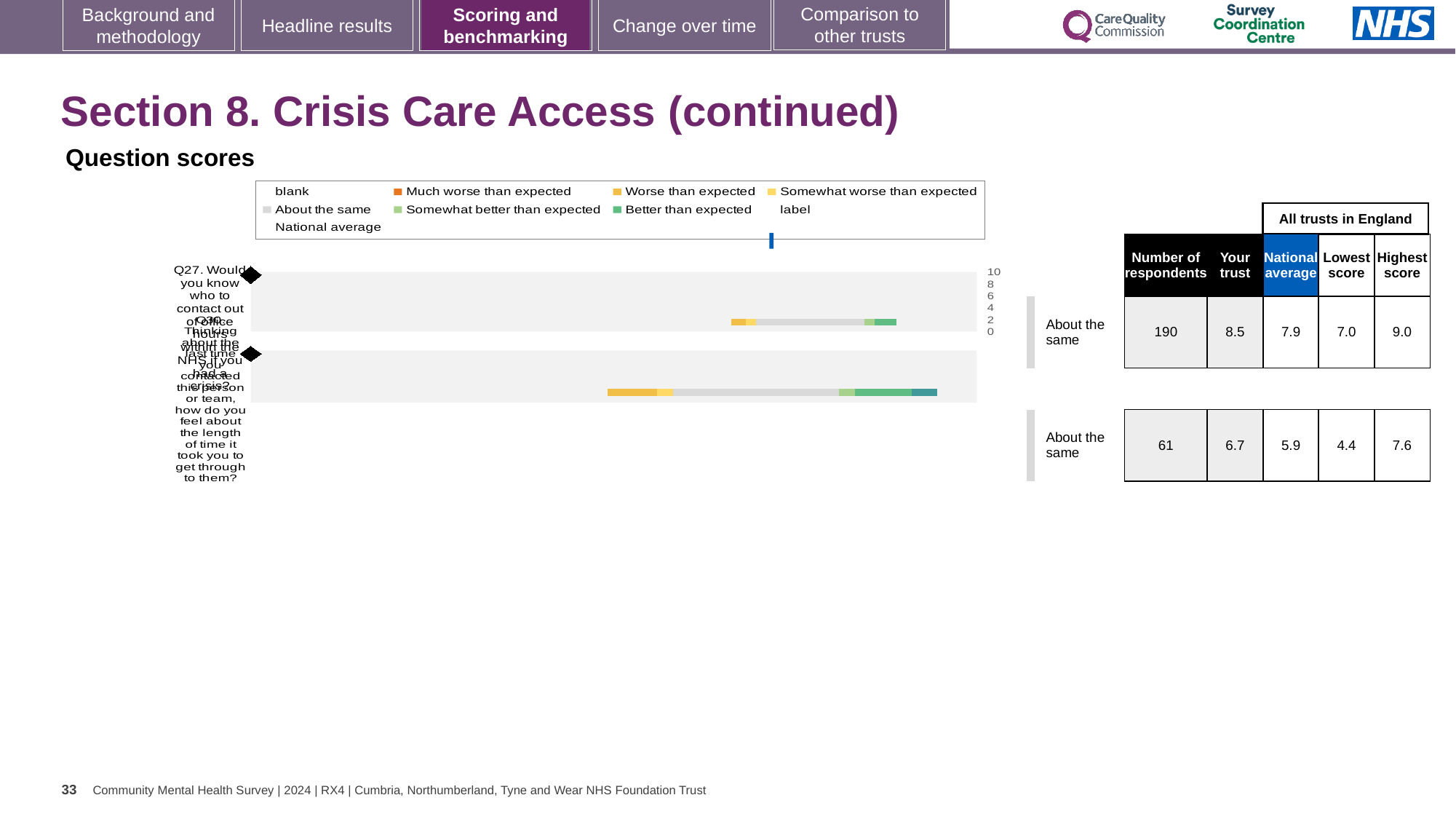
In the table beside the chart, what is the 'Your trust' score for Q27 (Would you know who to contact out of office hours)? 8.5 How many questions (categories) are plotted in the question scores chart? 2 What is the difference between the 'Your trust' score and the national average for Q27 in the table? 0.6 What benchmark category is shown next to the chart for both Q27 and Q28? About the same Which legend entry in the question scores chart is shown in orange? Much worse than expected In the table beside the chart, what is the highest score among all trusts in England for Q28? 7.6 What kind of chart is used to show the question scores on this slide? bar chart What is the difference between the 'Your trust' score and the national average for Q28 in the table? 0.8 In the table beside the chart, how many respondents answered Q27? 190 What is the highest value shown on the chart's numeric axis? 10 In the table beside the chart, what is the national average for Q28 (length of time it took to get through)? 5.9 Which question has the higher 'Your trust' score in the table, Q27 or Q28? Q27